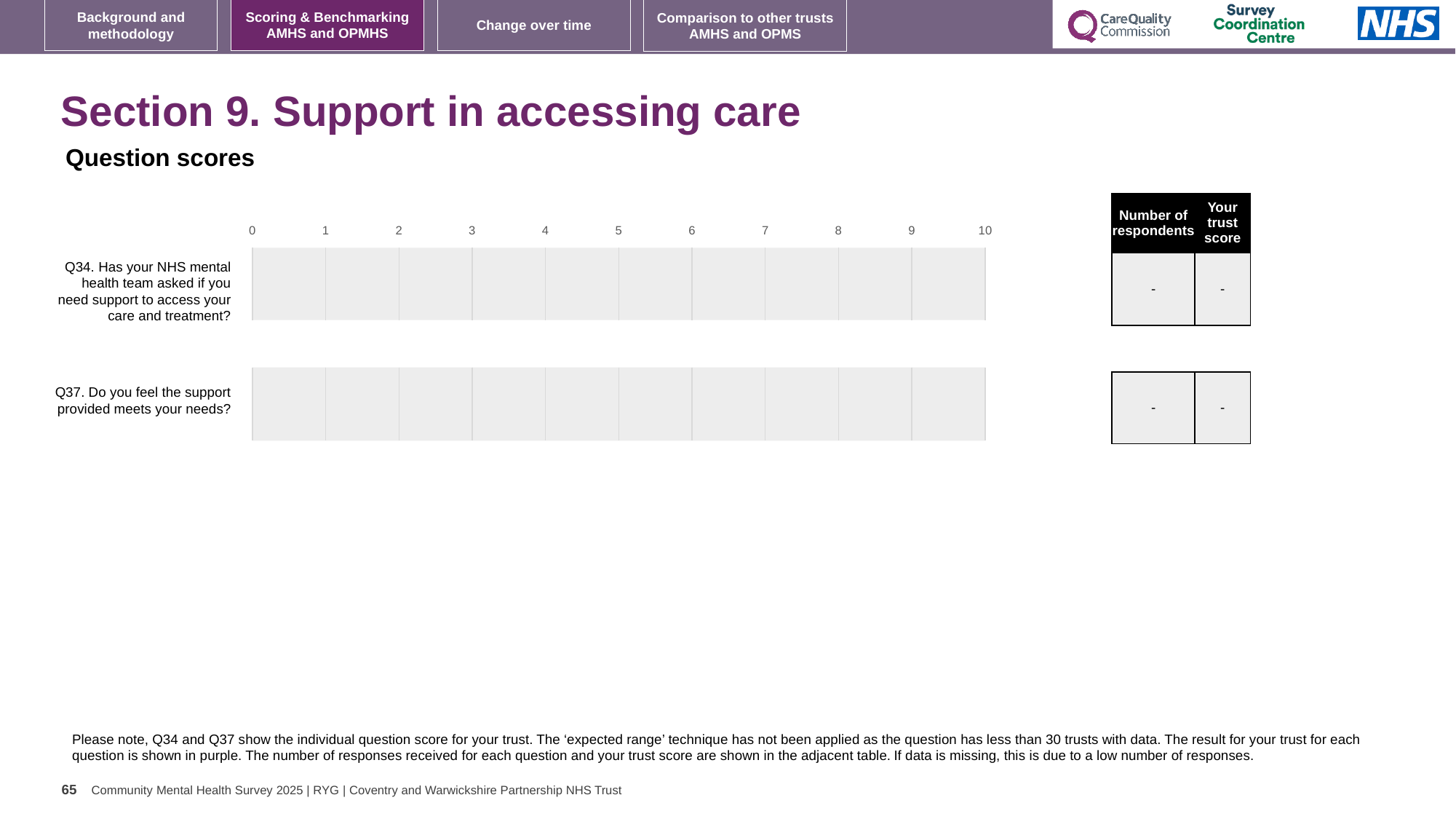
What is the lowest value shown on the chart's x axis? 0 What is the 'Number of respondents' value shown in the table for Q37? - How many questions (categories) are listed on the chart? 2 What kind of chart is shown on the slide? bar chart What is the 'Your trust score' value shown in the table for Q34? - What is the highest value shown on the chart's x axis? 10